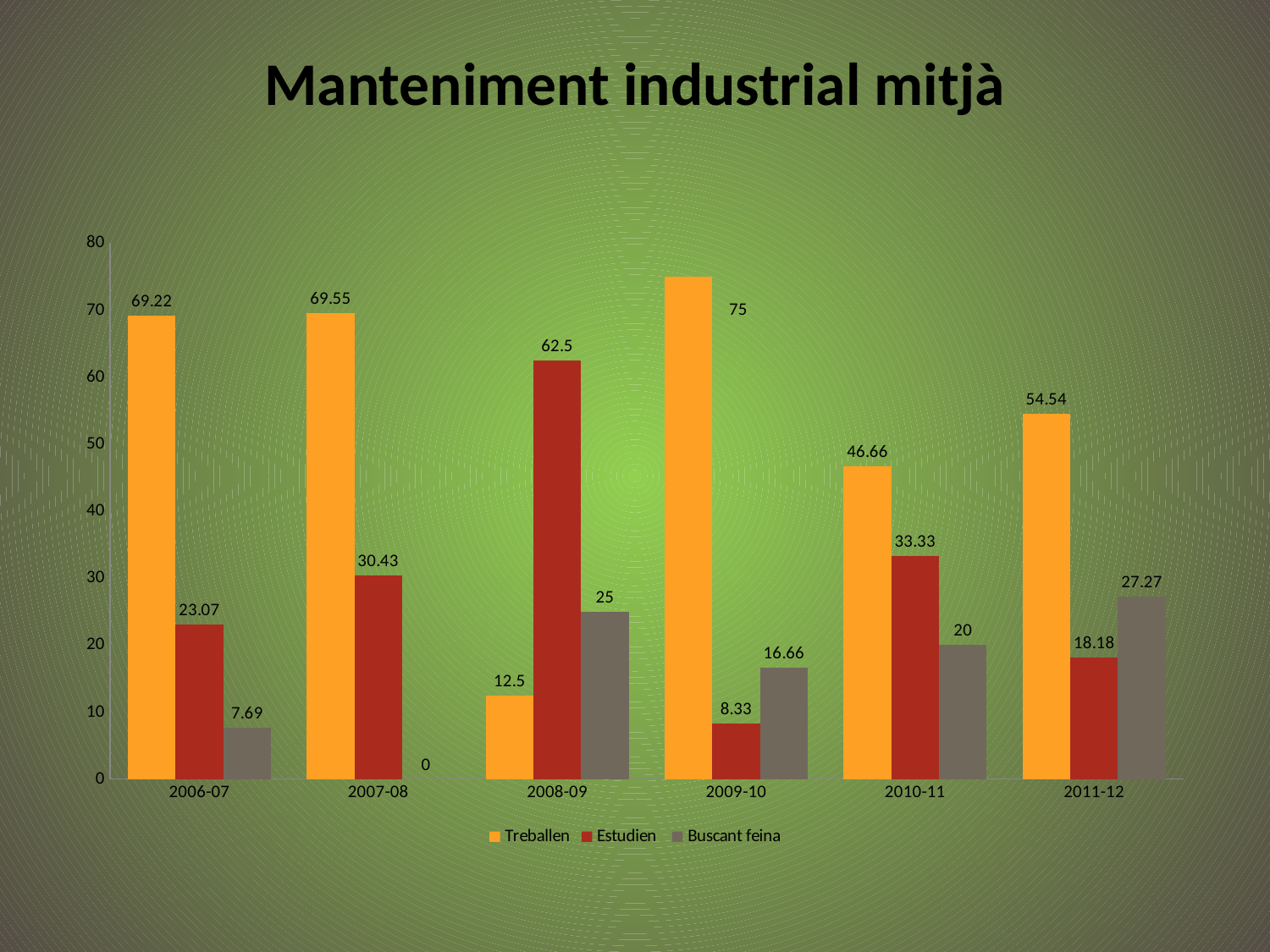
What is the value for Treballen in 2009-10? 75 How many series does the legend list? 3 Which year has the lowest value for Buscant feina? 2007-08 How many years are shown on the x axis? 6 Which year has the highest value for Treballen? 2009-10 What is the difference between the Treballen and Estudien values in 2010-11? 13.33 What is the value for Buscant feina in 2011-12? 27.27 What kind of chart is shown on the slide? Bar chart Which is larger in 2008-09, Treballen or Estudien? Estudien Is the value for Treballen in 2011-12 greater or less than 50? greater What is the value for Estudien in 2008-09? 62.5 What is the title of the chart? Manteniment industrial mitjà